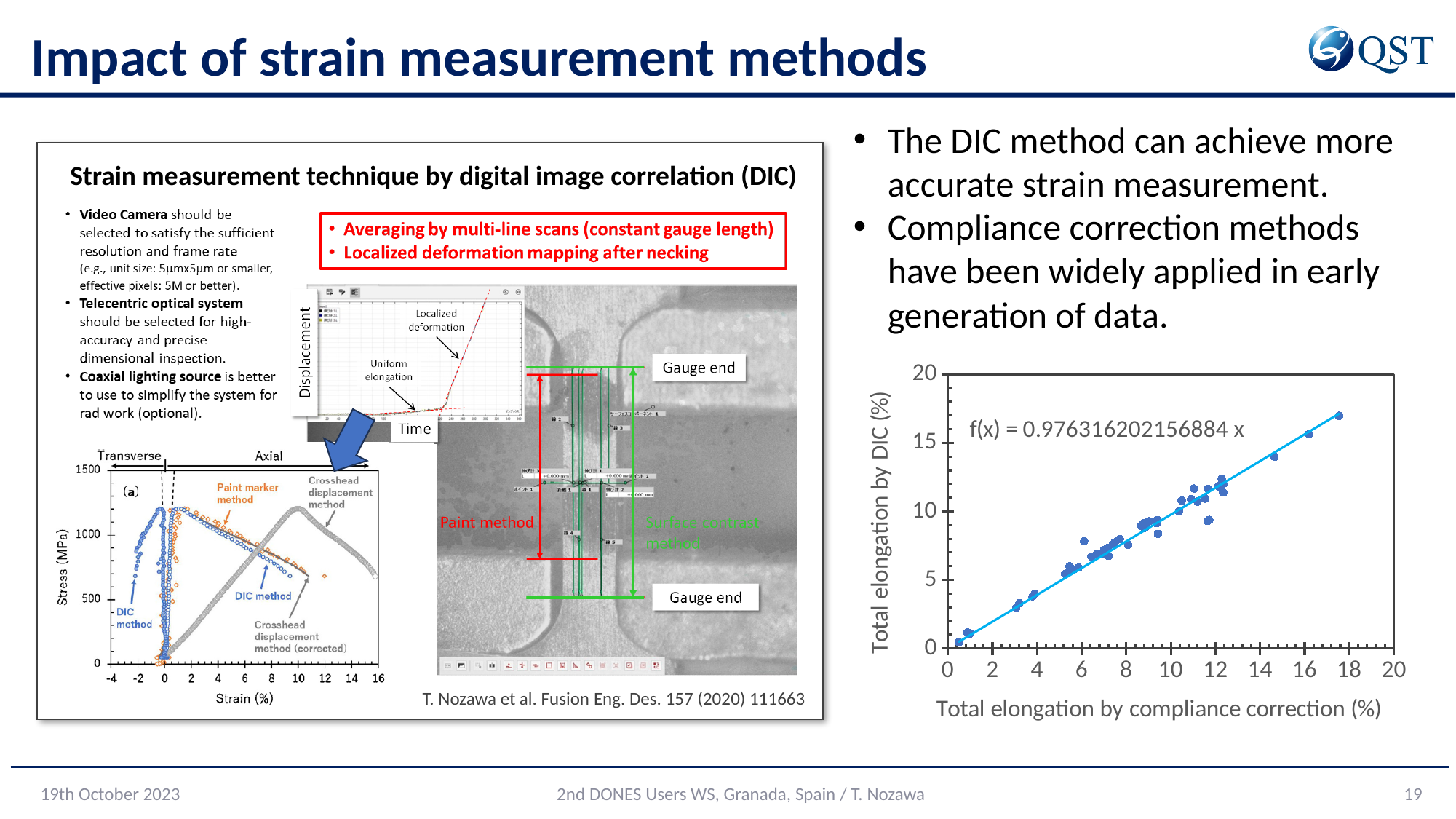
In the scatter chart on the right, is the lowest plotted point's y value greater or less than 5? less In the scatter chart on the right, what is the label of the x axis? Total elongation by compliance correction (%) In the scatter chart on the right, what is the label of the y axis? Total elongation by DIC (%) In the scatter chart on the right, is the slope of the fitted trendline greater or less than 1? less What kind of chart is shown on the right side of the slide? scatter chart In the scatter chart on the right, do the plotted values rise or fall as the x-axis value increases? rise In the scatter chart on the right, what is the maximum value shown on the y axis? 20 In the scatter chart on the right, is the highest plotted point's y value greater or less than 15? greater In the scatter chart on the right, what is the equation of the fitted trendline shown on the chart? f(x) = 0.976316202156884 x In the scatter chart on the right, what is the maximum value shown on the x axis? 20